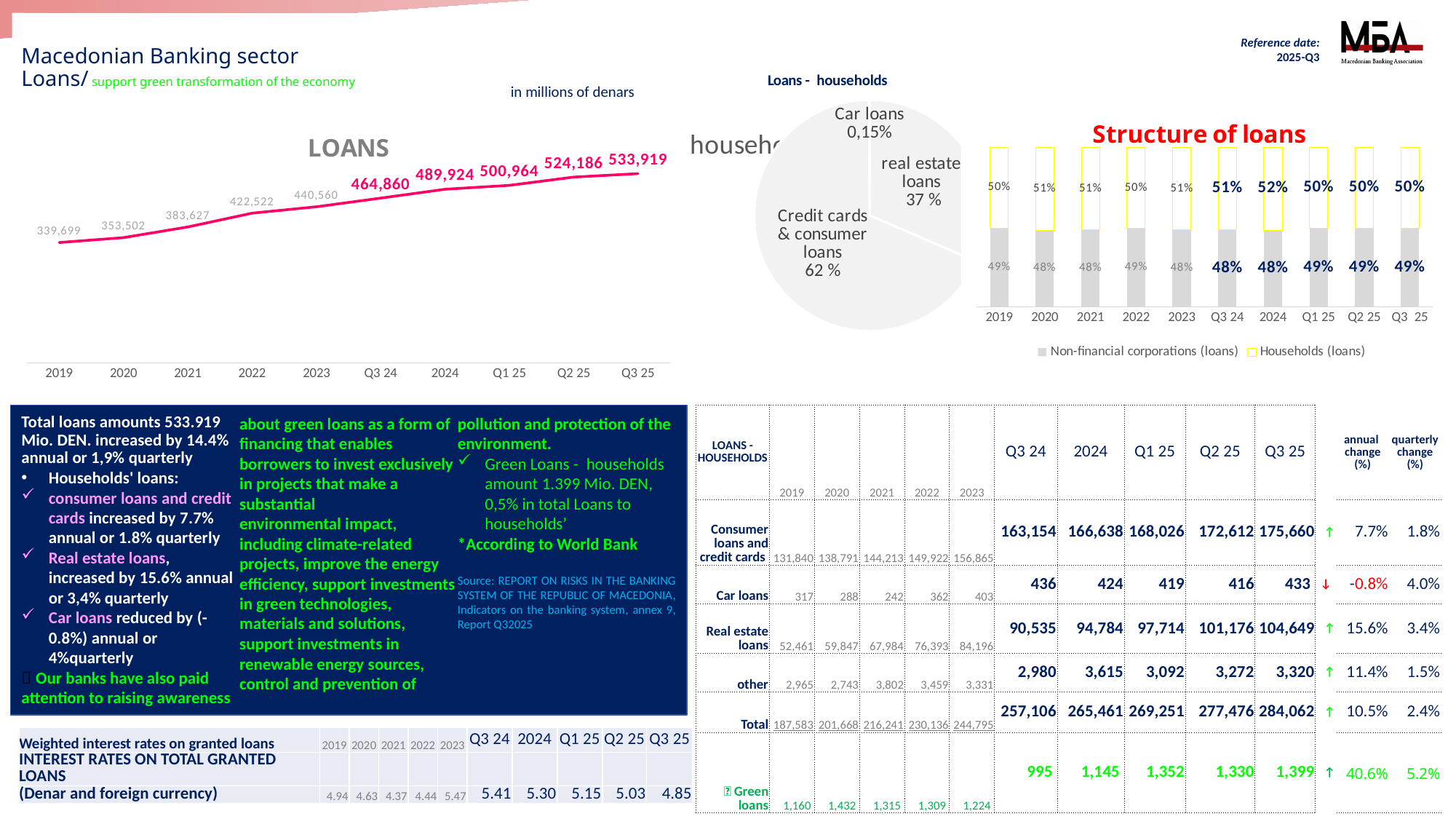
On the LOANS line chart, which year or quarter has the highest value? Q3 25 On the LOANS line chart, what is the value for Q3 25? 533,919 On the Loans - households pie chart, what share do car loans have? 0,15% On the Structure of loans chart, what is the Households (loans) share for 2024? 52% On the LOANS line chart, which year or quarter has the lowest value? 2019 On the Loans - households pie chart, which slice is the largest? Credit cards & consumer loans On the LOANS line chart, what is the difference between the values for Q3 25 and 2019? 194,220 How many data points are plotted on the LOANS line chart? 10 On the LOANS line chart, do the values rise or fall from 2019 to Q3 25? rise On the LOANS line chart, what is the value for 2019? 339,699 On the Loans - households pie chart, what share do real estate loans have? 37 % How many series does the legend of the Structure of loans chart list? 2